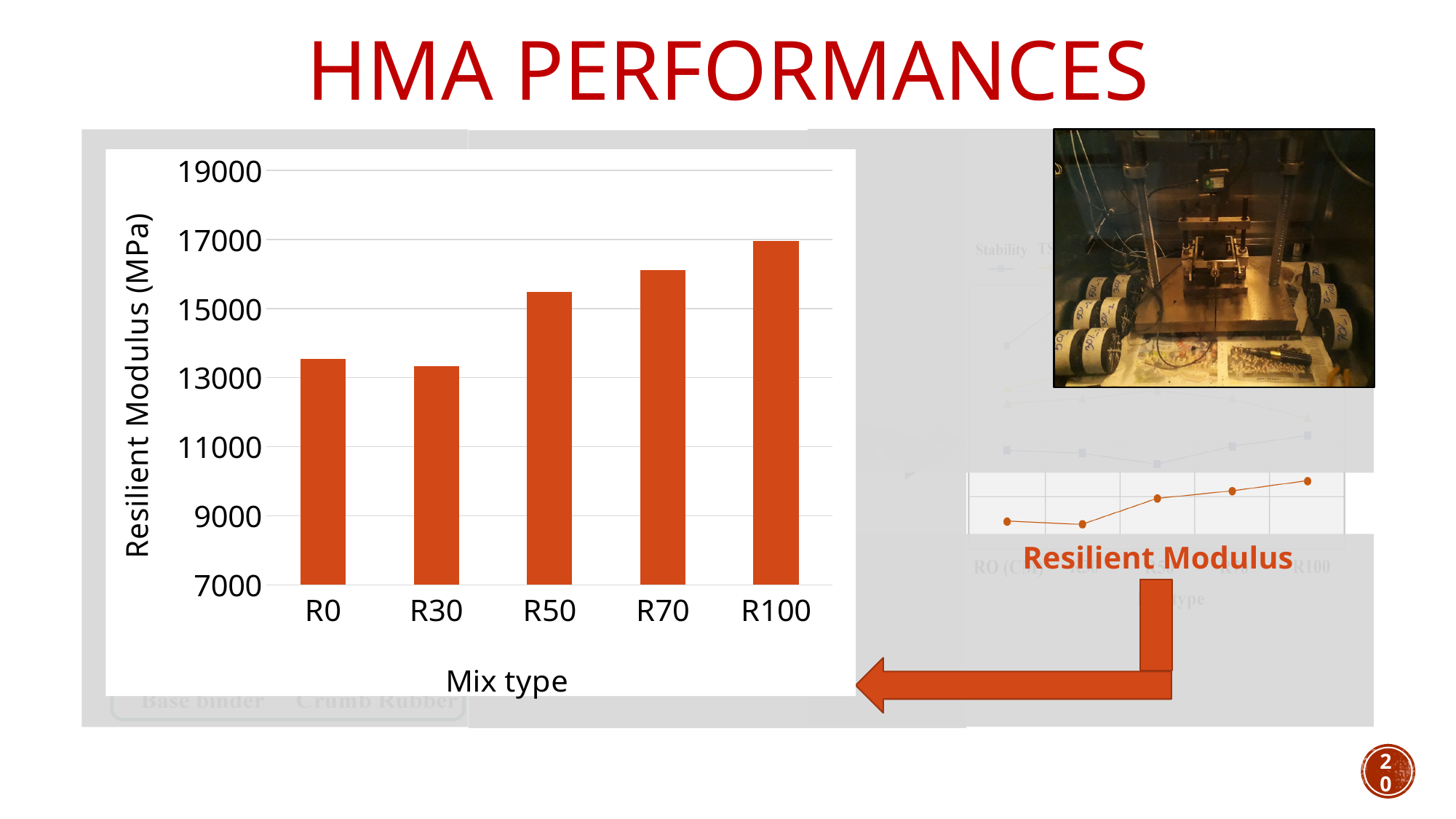
Which has a larger resilient modulus, R50 or R70? R70 Is the resilient modulus for R0 greater or less than 13000? greater Which mix type has the highest resilient modulus? R100 How many mix types are plotted on the bar chart? 5 Is the resilient modulus for R50 greater or less than 15000? greater What is the label of the horizontal axis of the bar chart? Mix type Is the resilient modulus for R100 greater or less than 15000? greater What kind of chart is shown on the slide? bar chart Which has a larger resilient modulus, R0 or R30? R0 What is the label of the vertical axis of the bar chart? Resilient Modulus (MPa) Which mix type has the lowest resilient modulus? R30